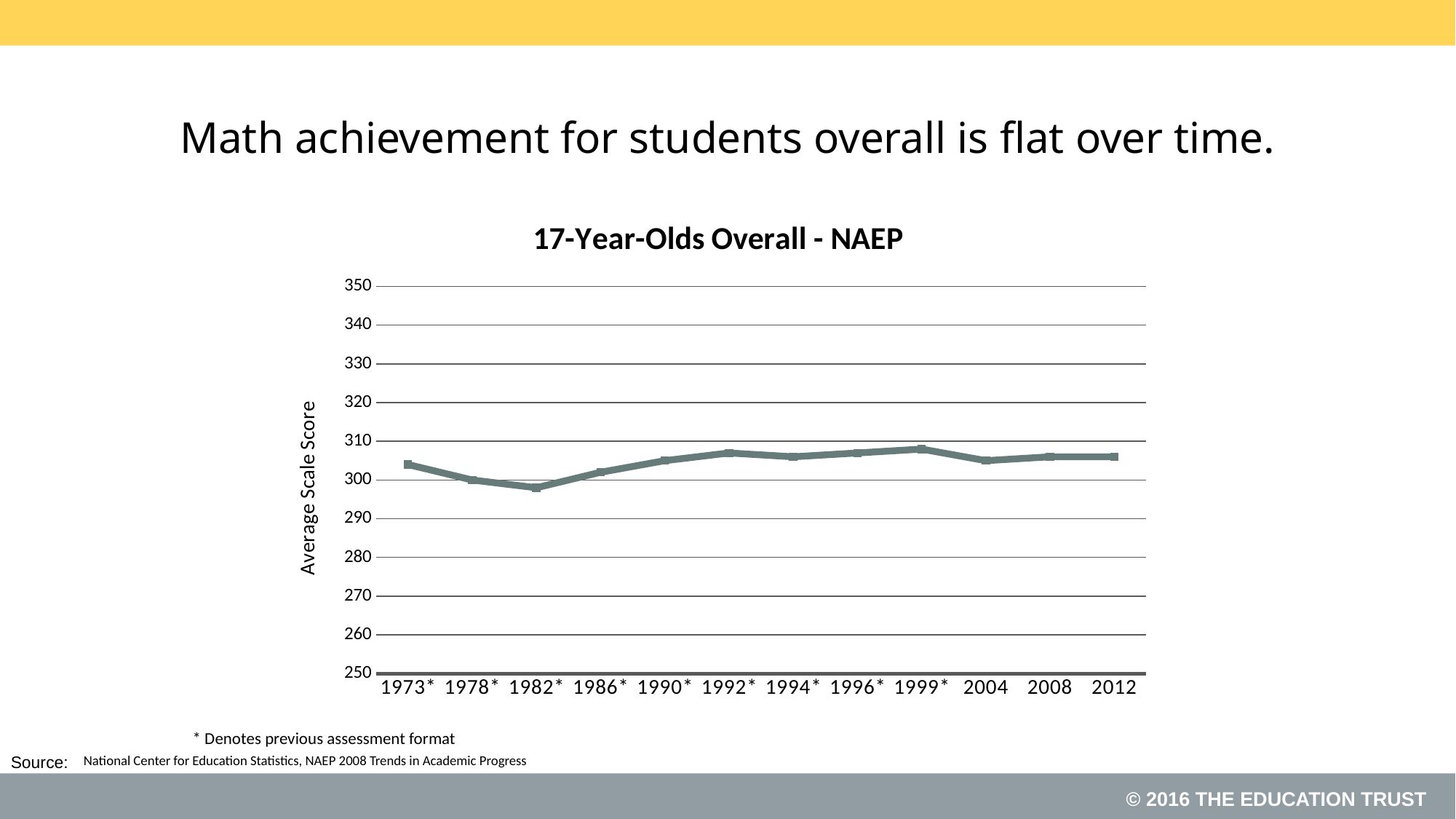
Is the value for 2012 greater or less than 300? greater Do the values rise or fall from 1973* to 1982*? fall Is the value for 1999* greater or less than 310? less Which year has the lowest average scale score in the chart? 1982* Which is larger, the value for 1982* or the value for 1992*? 1992* What kind of chart is shown on the slide? line chart Is the value for 1982* greater or less than 300? less What is the title of the chart? 17-Year-Olds Overall - NAEP How many years are plotted along the x axis of the chart? 12 What is the label on the vertical axis of the chart? Average Scale Score Which is larger, the value for 1973* or the value for 1982*? 1973*